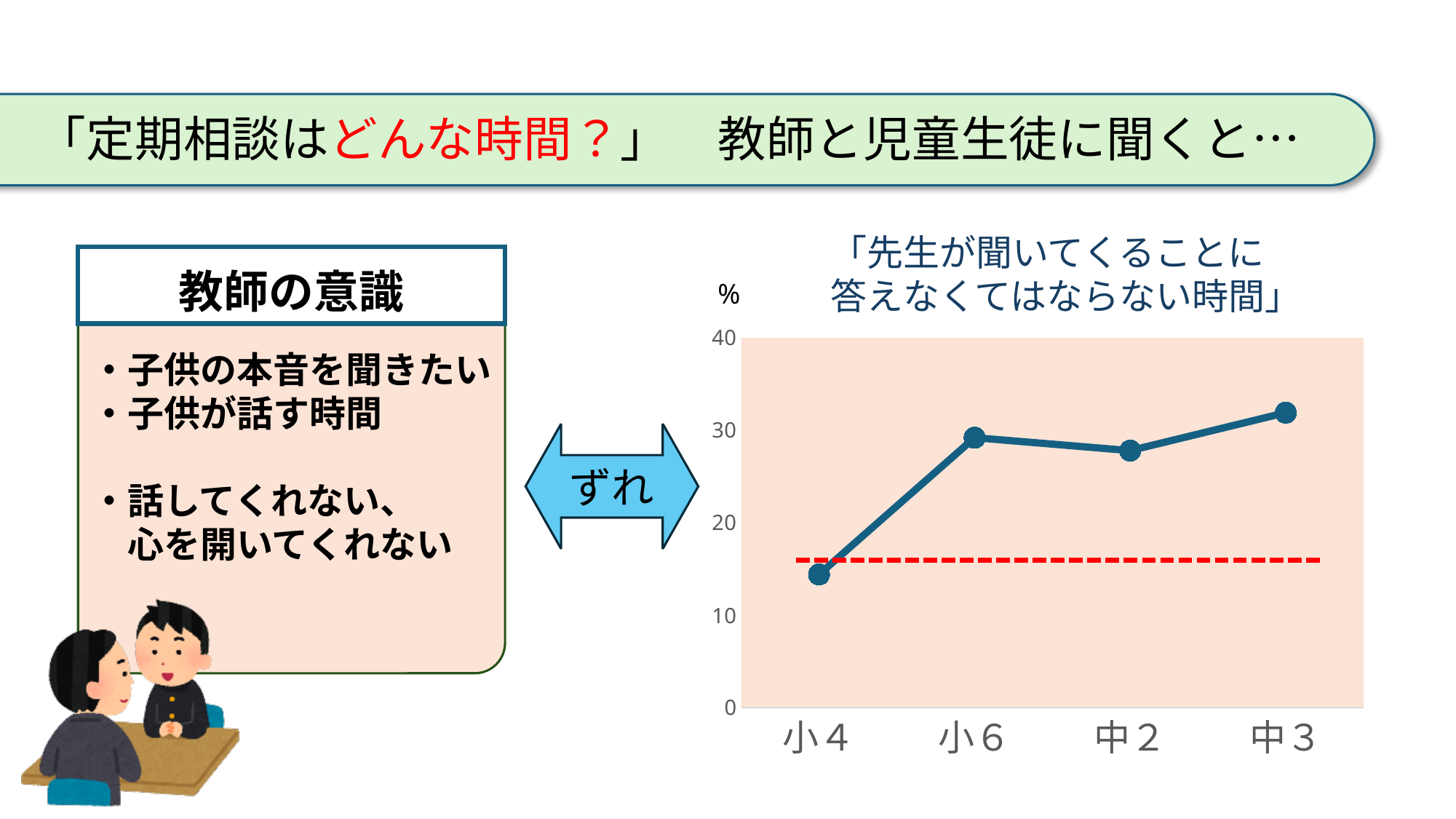
Does the line rise or fall from 小４ to 小６? rise What is the title of the line chart? 「先生が聞いてくることに答えなくてはならない時間」 Is the value for 小４ greater or less than 10? greater Is the value for 小４ greater or less than 20? less What kind of chart is shown on the slide? line chart Which category has the lowest value on the line chart? 小４ Is the value for 小６ greater or less than 20? greater How many data points are plotted on the line chart? 4 Which is larger, the value for 小４ or the value for 小６? 小６ Which category has the highest value on the line chart? 中３